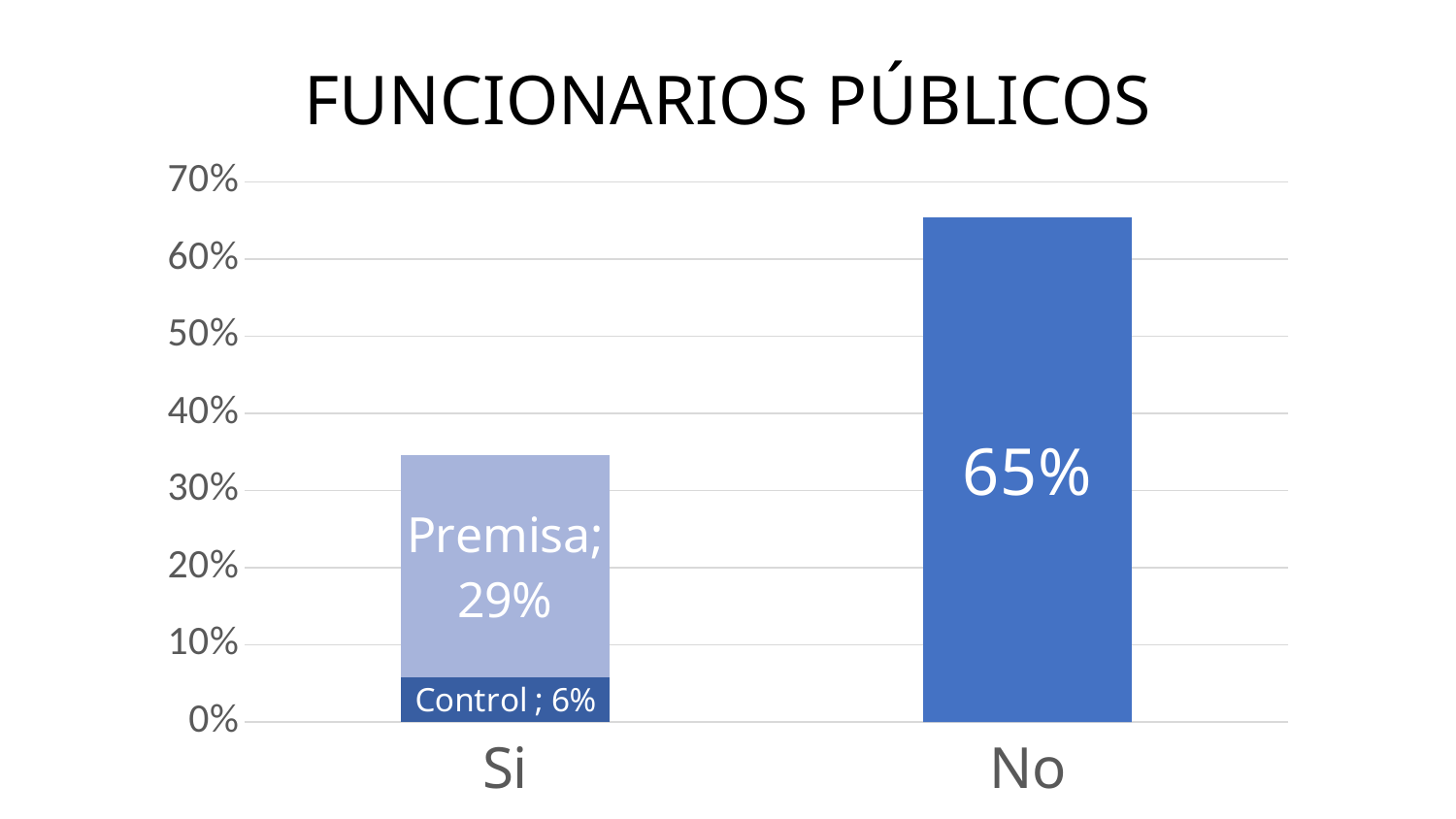
Is the total height of the Si bar greater or less than 30%? greater What is the value of the Premisa segment in the Si bar? 29% Which is larger: the No bar or the Premisa segment of the Si bar? No What is the value of the Control segment in the Si bar? 6% What is the difference between the No bar value (65%) and the Premisa segment of the Si bar (29%)? 36% What is the difference between the Premisa segment and the Control segment in the Si bar? 23% What value is labelled on the No bar? 65% What type of chart is shown on the slide? bar chart What is the total of the stacked Si bar (Control plus Premisa)? 35% How many categories are shown on the x axis? 2 What is the title of the chart? FUNCIONARIOS PÚBLICOS Which category has the tallest bar? No